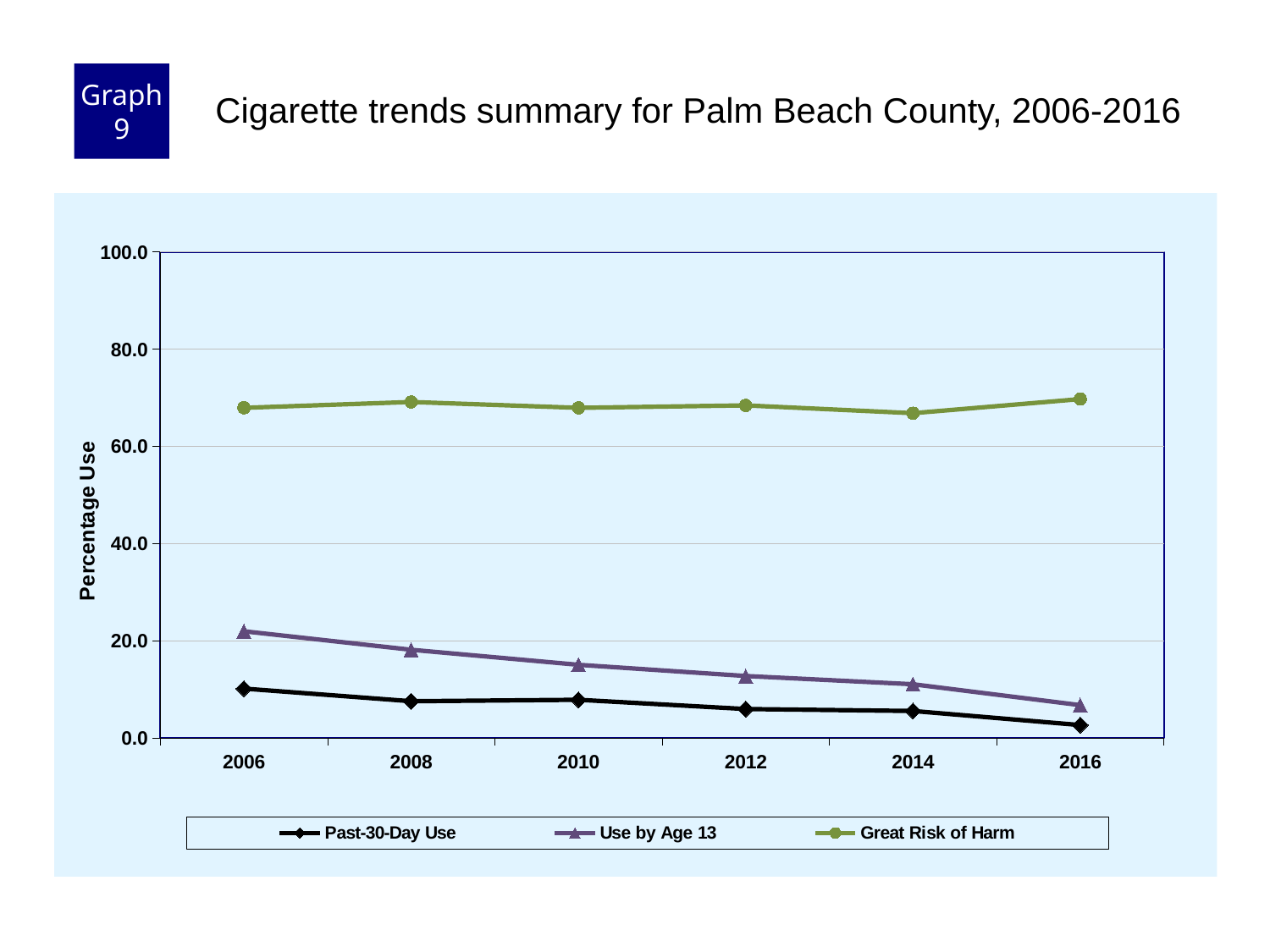
In which year is the Past-30-Day Use value lowest? 2016 How many series does the legend list? 3 In which year is the Use by Age 13 value highest? 2006 Does the Use by Age 13 series rise or fall from 2006 to 2016? fall Is the value for Great Risk of Harm in 2006 greater or less than 60.0? greater What kind of chart is shown on the slide? line chart Which is larger in 2006, Use by Age 13 or Past-30-Day Use? Use by Age 13 Is the value for Use by Age 13 in 2016 greater or less than 20.0? less How many years are plotted along the x axis? 6 Which series has the highest value in 2016? Great Risk of Harm What is the title of the y axis? Percentage Use Is the value for Great Risk of Harm in 2016 greater or less than 80.0? less